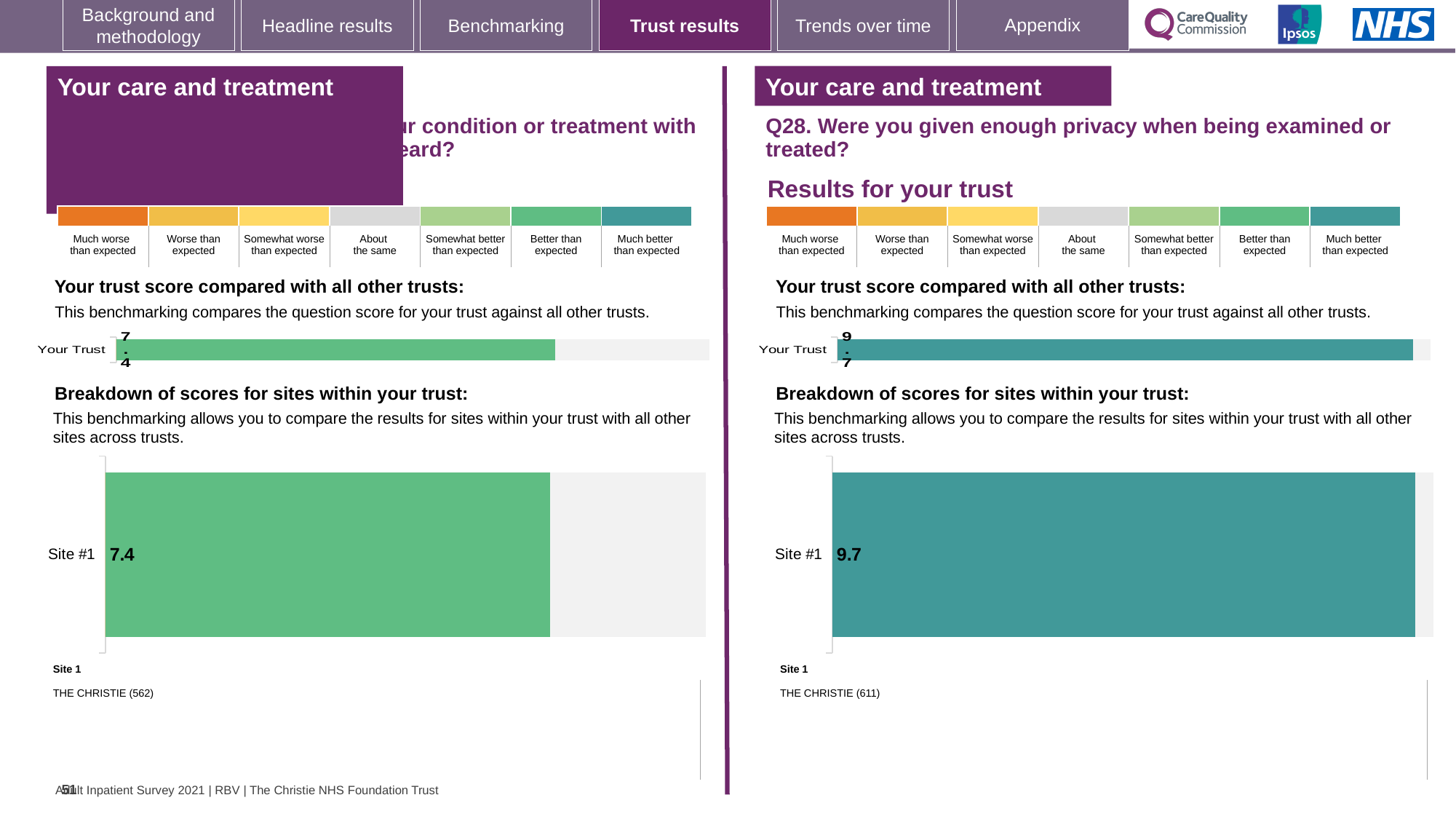
On the right-hand chart for Q28, which benchmark category does the colour of the Your Trust bar correspond to? Much better than expected Which site name is listed as Site 1 beneath the left-hand chart, and how many respondents are shown in brackets? THE CHRISTIE (562) On the left-hand chart, which benchmark category does the colour of the Your Trust bar correspond to? Better than expected What type of chart is used to show the Site #1 score on the left-hand side of the slide? Bar chart On the left-hand chart, what is the score for Site #1 in the breakdown of scores for sites within your trust? 7.4 Which is larger: the Site #1 score on the left-hand chart or the Site #1 score on the right-hand chart for Q28? The right-hand chart (Q28) On the right-hand chart for Q28 (privacy when being examined or treated), what is the score shown for Your Trust? 9.7 How many sites are shown in the breakdown of scores on the right-hand chart for Q28? 1 On the right-hand chart for Q28, what is the score for Site #1 in the breakdown of scores for sites within your trust? 9.7 What is the difference between the Site #1 score on the right-hand chart for Q28 and the Site #1 score on the left-hand chart? 2.3 On the left-hand chart, what is the score shown for Your Trust? 7.4 Which site name is listed as Site 1 beneath the right-hand chart for Q28, and how many respondents are shown in brackets? THE CHRISTIE (611)